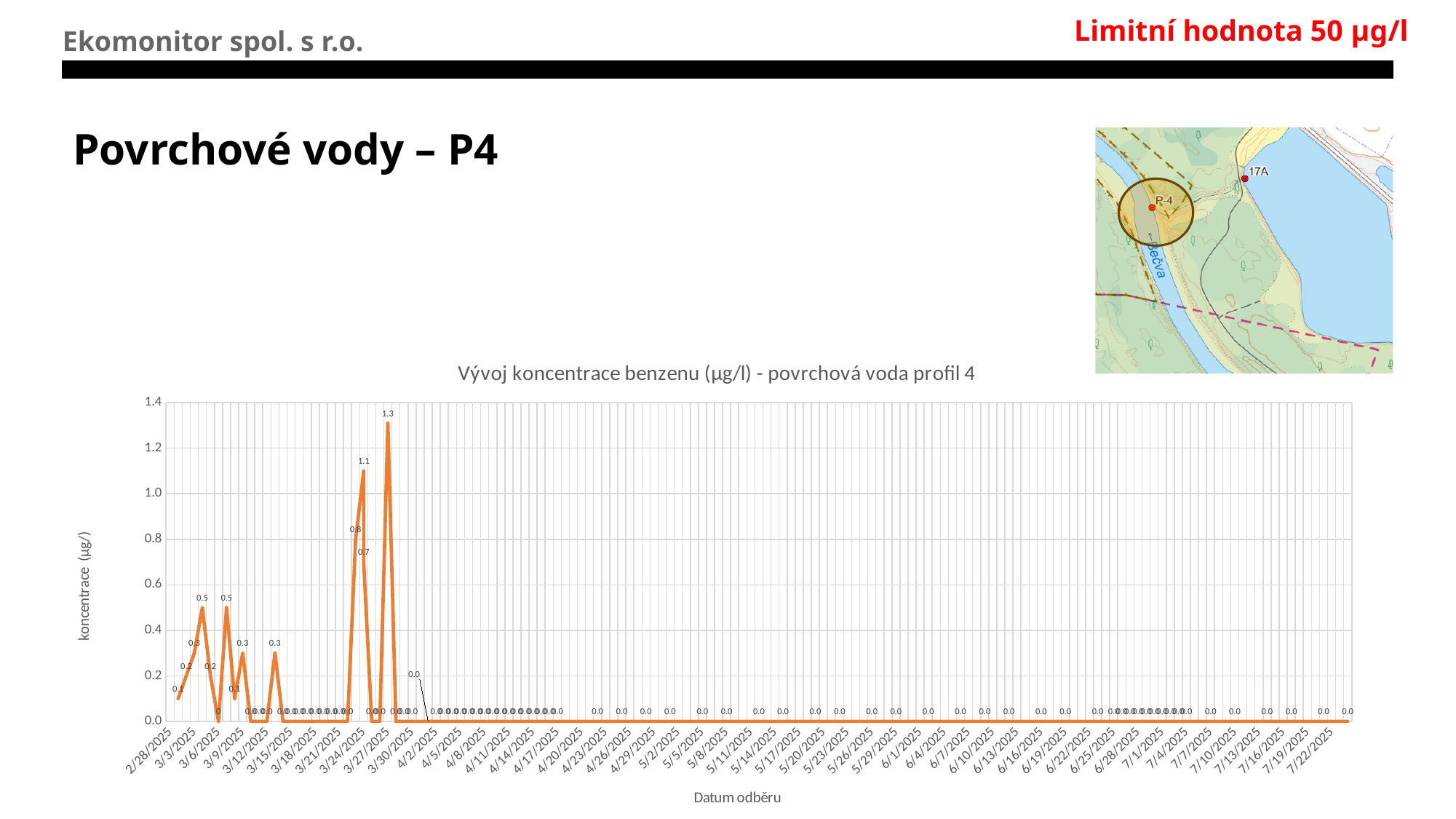
What is the label of the vertical axis of the chart? koncentrace (µg/l) What is the highest benzene concentration value plotted on the chart? 1.3 Is the highest plotted value greater or less than 1.0? greater What is the difference between the highest plotted value (1.3) and the second-highest peak (1.1)? 0.2 How many data series are plotted on the chart? 1 What kind of chart is shown on the slide? line chart What is the lowest value shown on the chart's vertical axis? 0.0 Do the plotted values rise or fall from the late-March peak to the end of the series in July? fall Which is larger: the peak value of 1.3 in late March or the peak value of 0.5 in early March? 1.3 What is the title of the chart? Vývoj koncentrace benzenu (µg/l) - povrchová voda profil 4